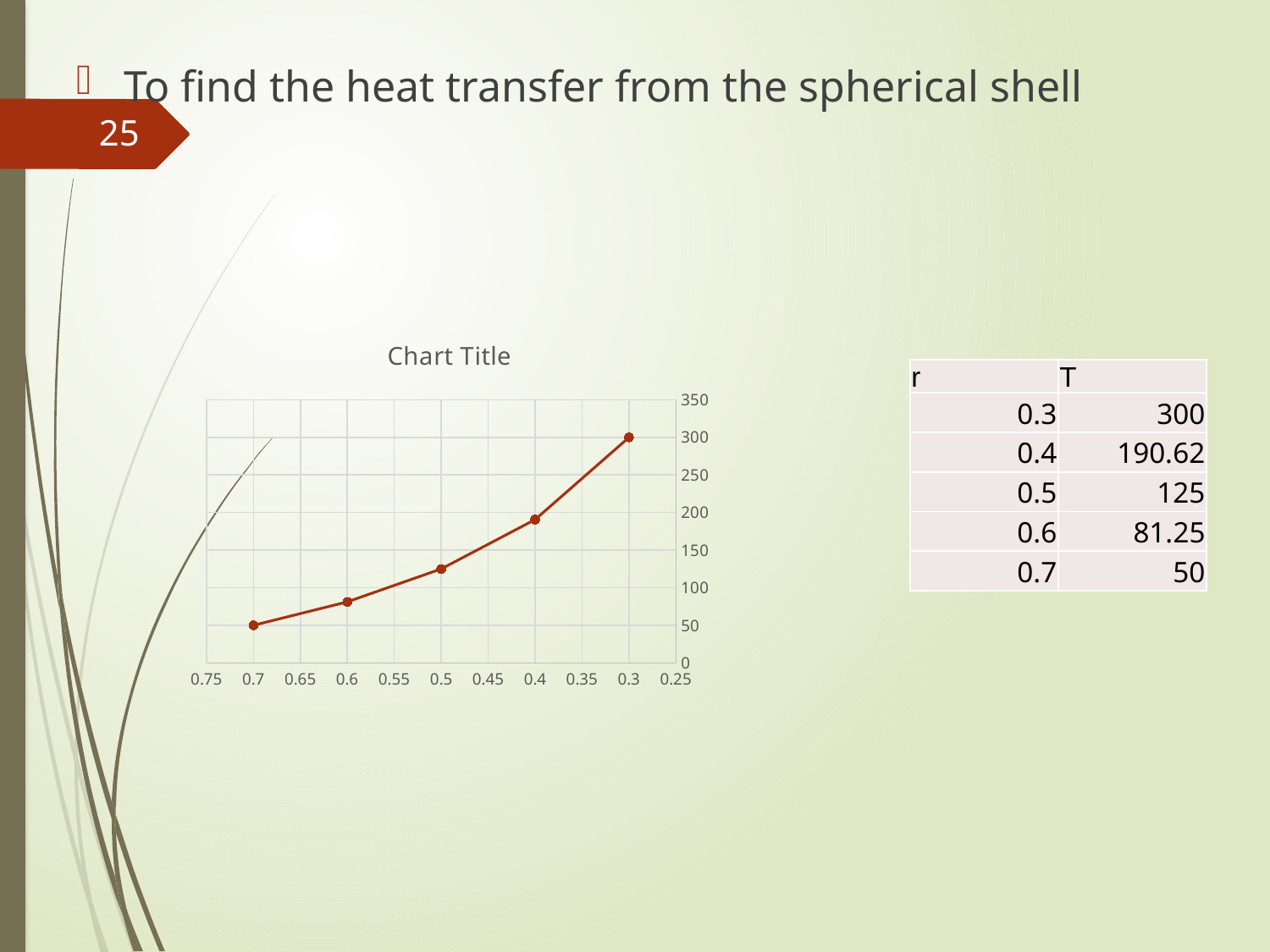
What kind of chart is shown on the slide? line chart What is the value of T at r = 0.3? 300 What is the title of the chart? Chart Title At which value of r is T lowest? 0.7 At which value of r is T highest? 0.3 What is the value of T at r = 0.4? 190.62 What is the value of T at r = 0.6? 81.25 What is the difference between T at r = 0.3 and T at r = 0.7? 250 What is the value of T at r = 0.7? 50 How many data points are plotted on the chart? 5 Is the value of T at r = 0.5 greater or less than 100? greater Which is larger, T at r = 0.5 or T at r = 0.6? T at r = 0.5